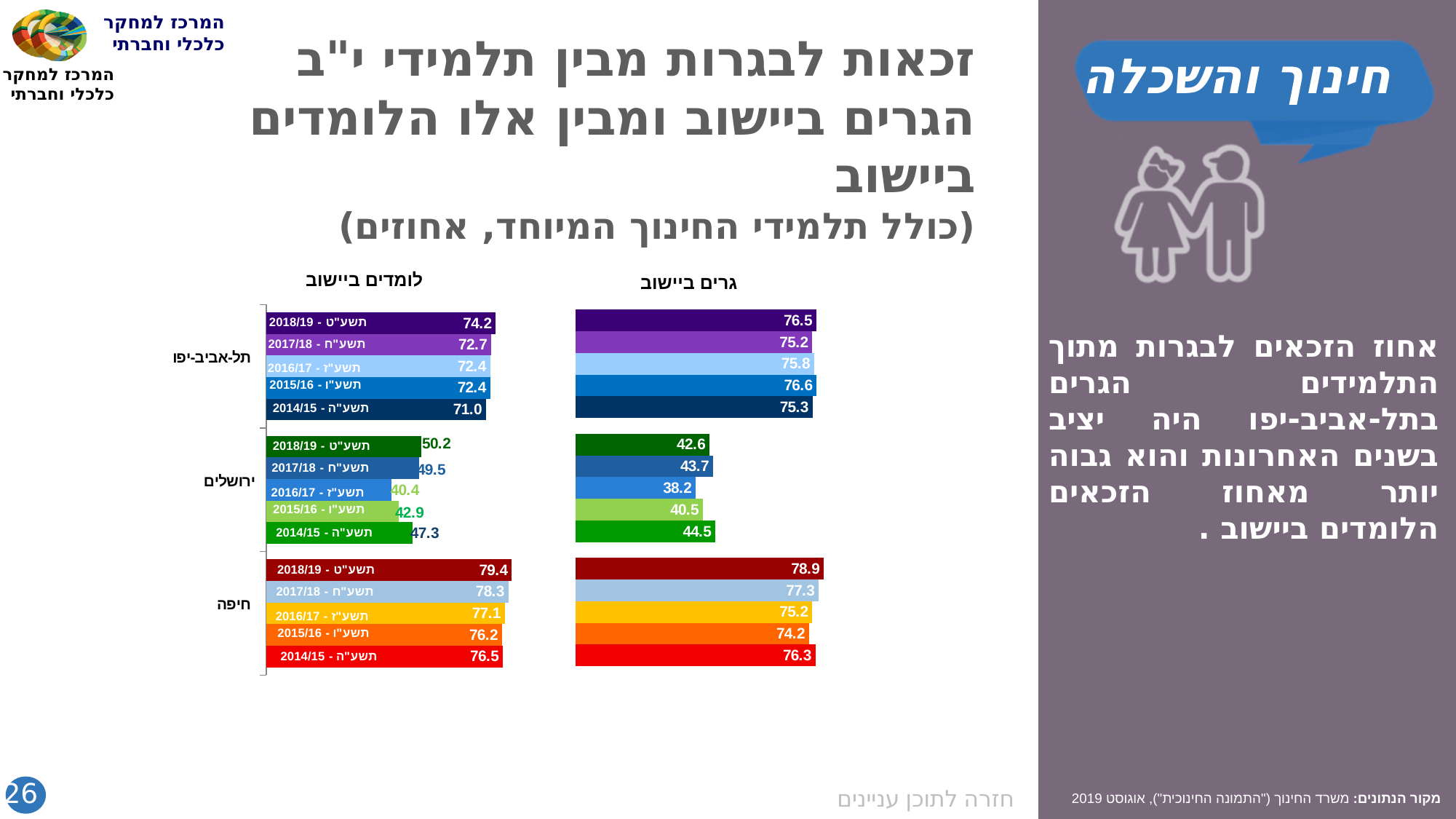
What type of chart is the "גרים ביישוב" chart? Bar chart For ירושלים in 2018/19 - תשע"ט, which is larger: the "לומדים ביישוב" value or the "גרים ביישוב" value? לומדים ביישוב How many cities are shown in the "לומדים ביישוב" chart? 3 In the "גרים ביישוב" chart, what is the value for ירושלים in 2016/17 - תשע"ז? 38.2 How many years are shown for each city in the "גרים ביישוב" chart? 5 In the "גרים ביישוב" chart, what is the value for חיפה in 2018/19 - תשע"ט? 78.9 In the "לומדים ביישוב" chart, which year has the highest value for חיפה? 2018/19 - תשע"ט In the "לומדים ביישוב" chart, what is the value for תל-אביב-יפו in 2018/19 - תשע"ט? 74.2 In the "לומדים ביישוב" chart, what is the difference between the 2018/19 and 2014/15 values for תל-אביב-יפו? 3.2 In the "גרים ביישוב" chart, what is the difference between the 2018/19 and 2016/17 values for חיפה? 3.7 In the "לומדים ביישוב" chart, which year has the lowest value for ירושלים? 2016/17 - תשע"ז In the "גרים ביישוב" chart, which year has the highest value for תל-אביב-יפו? 2015/16 - תשע"ו